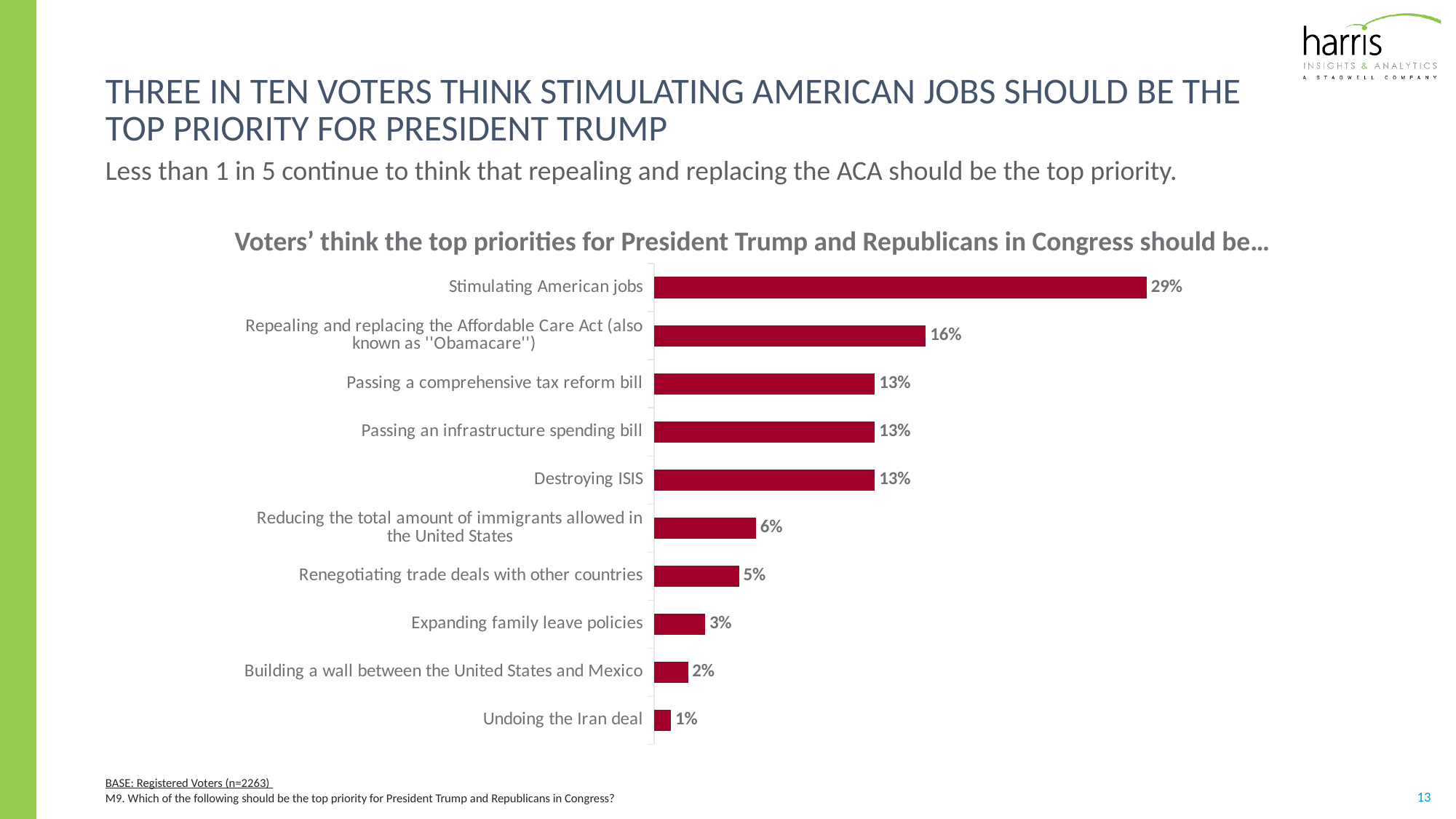
What is the title of the chart? Voters' think the top priorities for President Trump and Republicans in Congress should be… What percentage of voters think stimulating American jobs should be the top priority? 29% Which priority has the highest percentage of voters? Stimulating American jobs What is the value for 'Building a wall between the United States and Mexico'? 2% Which has a larger value: 'Reducing the total amount of immigrants allowed in the United States' or 'Expanding family leave policies'? Reducing the total amount of immigrants allowed in the United States How many priorities share the value of 13%? 3 Which priority has the lowest percentage of voters? Undoing the Iran deal What is the value for 'Renegotiating trade deals with other countries'? 5% What percentage of voters chose repealing and replacing the Affordable Care Act as the top priority? 16% What is the difference in percentage points between 'Stimulating American jobs' and 'Repealing and replacing the Affordable Care Act'? 13 percentage points What type of chart is shown on the slide? Bar chart How many priorities are shown in the chart? 10